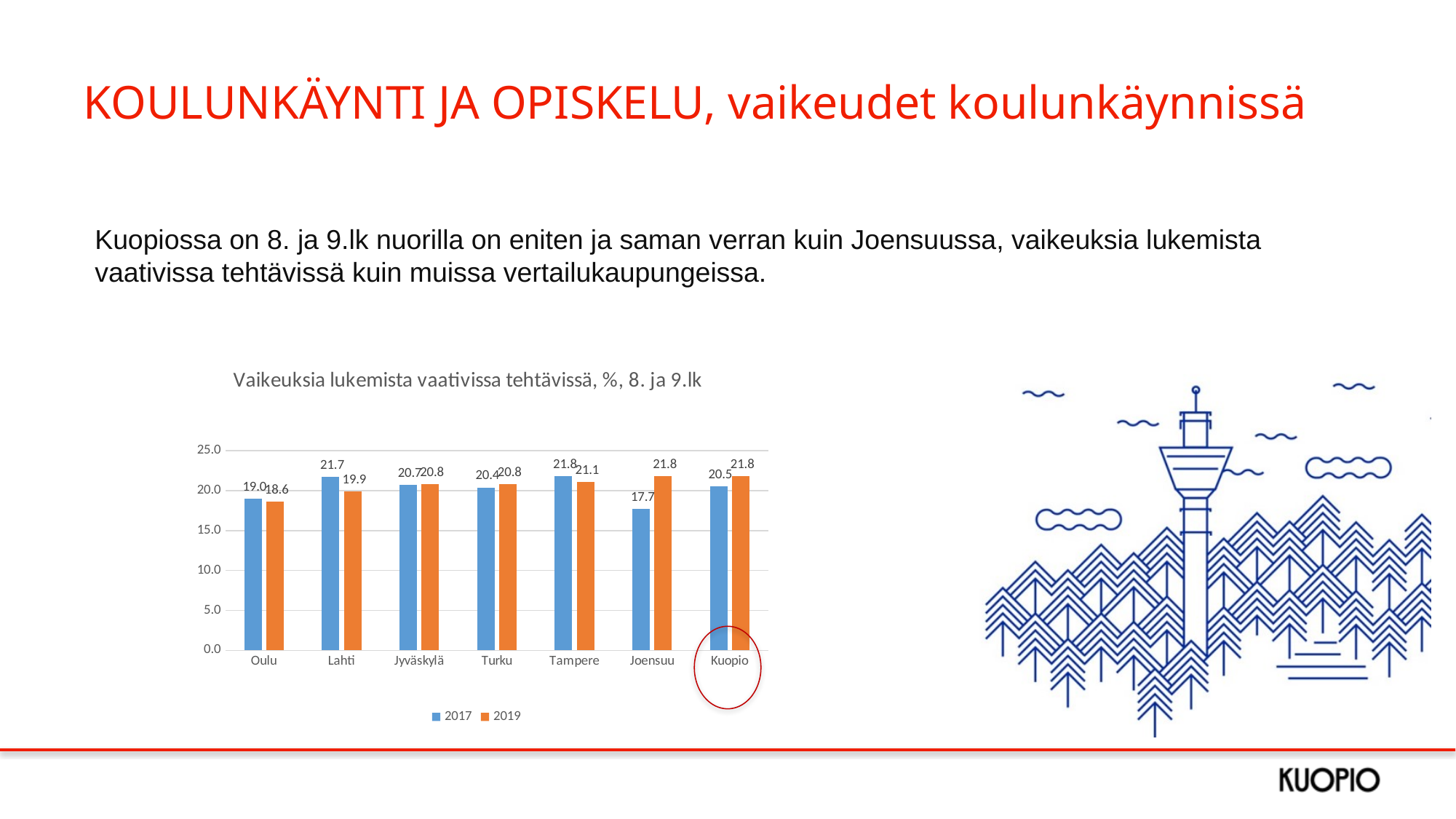
Which city has the lowest 2019 value? Oulu How many series does the legend list? 2 What is the title of the chart? Vaikeuksia lukemista vaativissa tehtävissä, %, 8. ja 9.lk For Oulu, which year has the larger value, 2017 or 2019? 2017 What kind of chart is shown on the slide? Bar chart Which city has the lowest 2017 value? Joensuu What is the 2017 value for Joensuu? 17.7 What is the 2019 value for Tampere? 21.1 What is the 2019 value for Kuopio? 21.8 What is the difference between the 2017 and 2019 values for Lahti? 1.8 By how much did the value for Joensuu increase from 2017 to 2019? 4.1 How many cities are shown on the x axis? 7